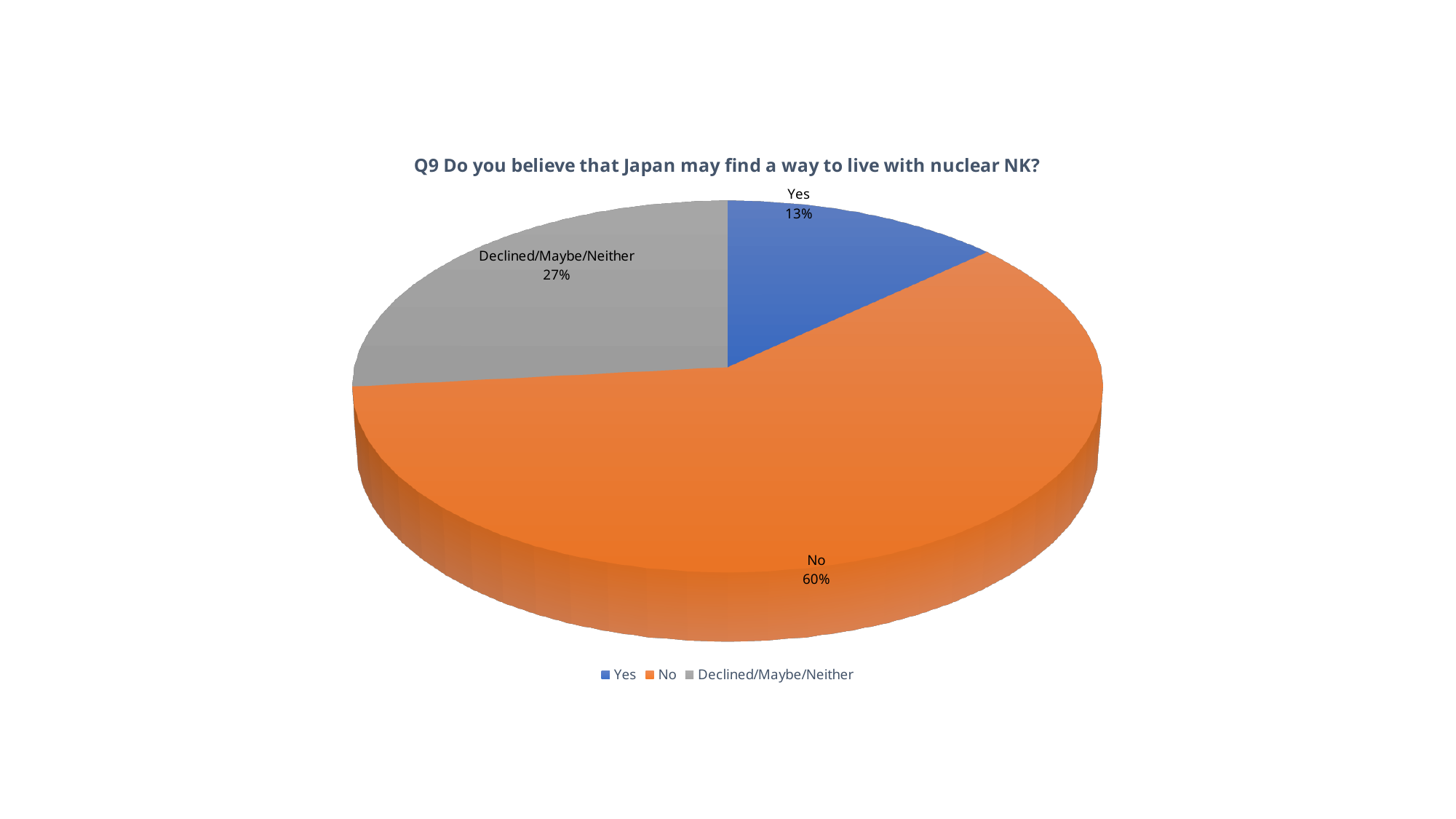
How many slices does the pie chart have? 3 How many entries does the legend list? 3 Which response has the smallest share of the pie? Yes What is the difference in percentage points between the "No" and "Yes" slices? 47 What percentage of respondents answered "No"? 60% Which is larger, the "Declined/Maybe/Neither" slice or the "Yes" slice? Declined/Maybe/Neither What is the title of the chart? Q9 Do you believe that Japan may find a way to live with nuclear NK? What percentage of respondents answered "Yes"? 13% What share of the pie is labelled "Declined/Maybe/Neither"? 27% What kind of chart is shown on the slide? Pie chart Which response has the largest share of the pie? No What is the difference in percentage points between the "Declined/Maybe/Neither" and "Yes" slices? 14